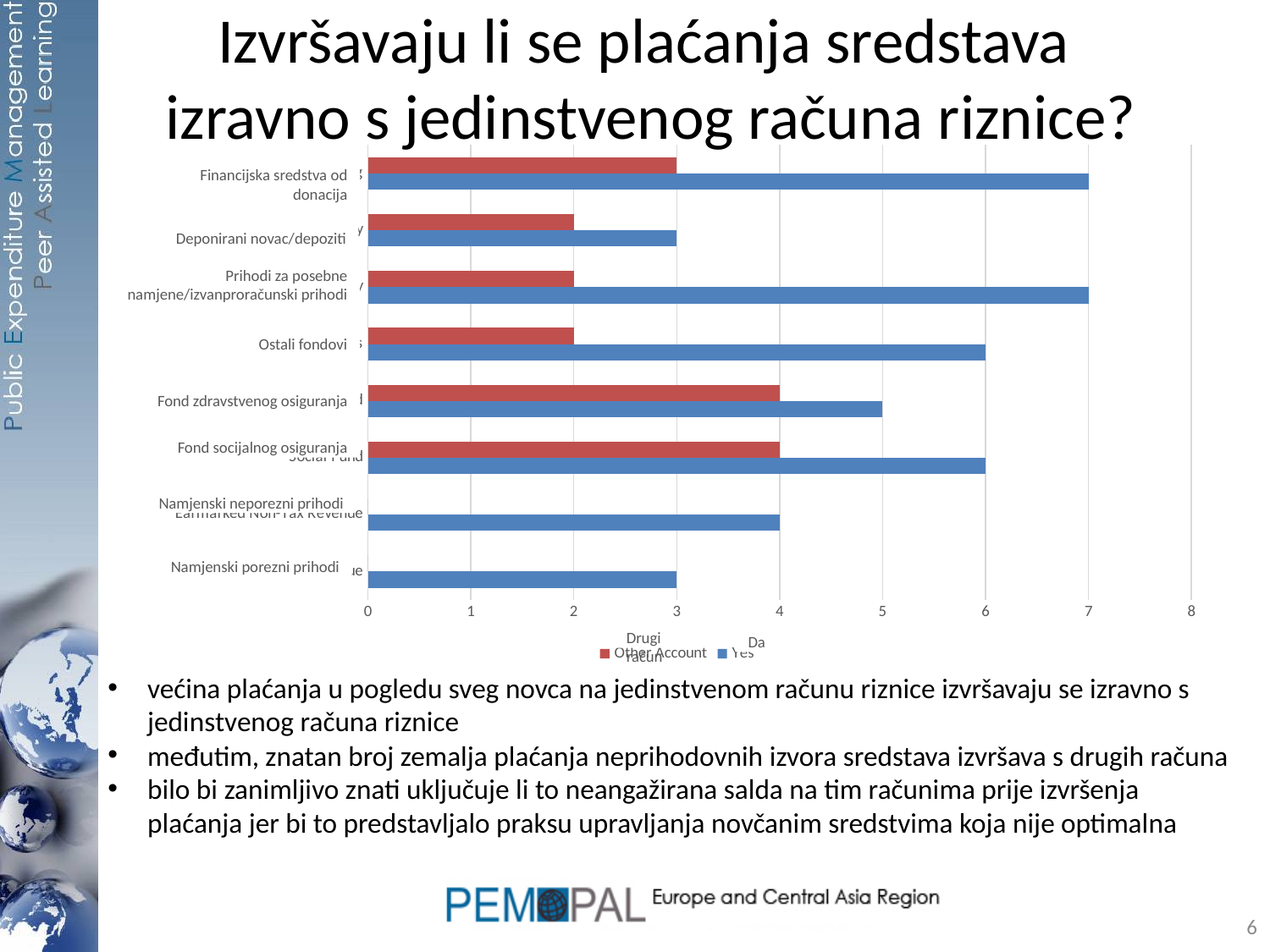
What colour are the 'Da' bars in the chart? blue What is the 'Drugi račun' value for Fond zdravstvenog osiguranja? 4 What is the 'Da' value for Namjenski porezni prihodi? 3 What is the 'Da' value for Financijska sredstva od donacija? 7 What is the difference between the 'Da' and 'Drugi račun' values for Ostali fondovi? 4 Which category has the lowest 'Da' value? Namjenski porezni prihodi and Deponirani novac/depoziti (both 3) How many series does the chart legend list? 2 Is the 'Da' value for Prihodi za posebne namjene/izvanproračunski prihodi greater or less than 5? greater What kind of chart is shown on the slide? bar chart Which is larger for Deponirani novac/depoziti: the 'Da' value or the 'Drugi račun' value? Da How many categories are shown on the chart's vertical axis? 8 What is the 'Da' value for Fond socijalnog osiguranja? 6